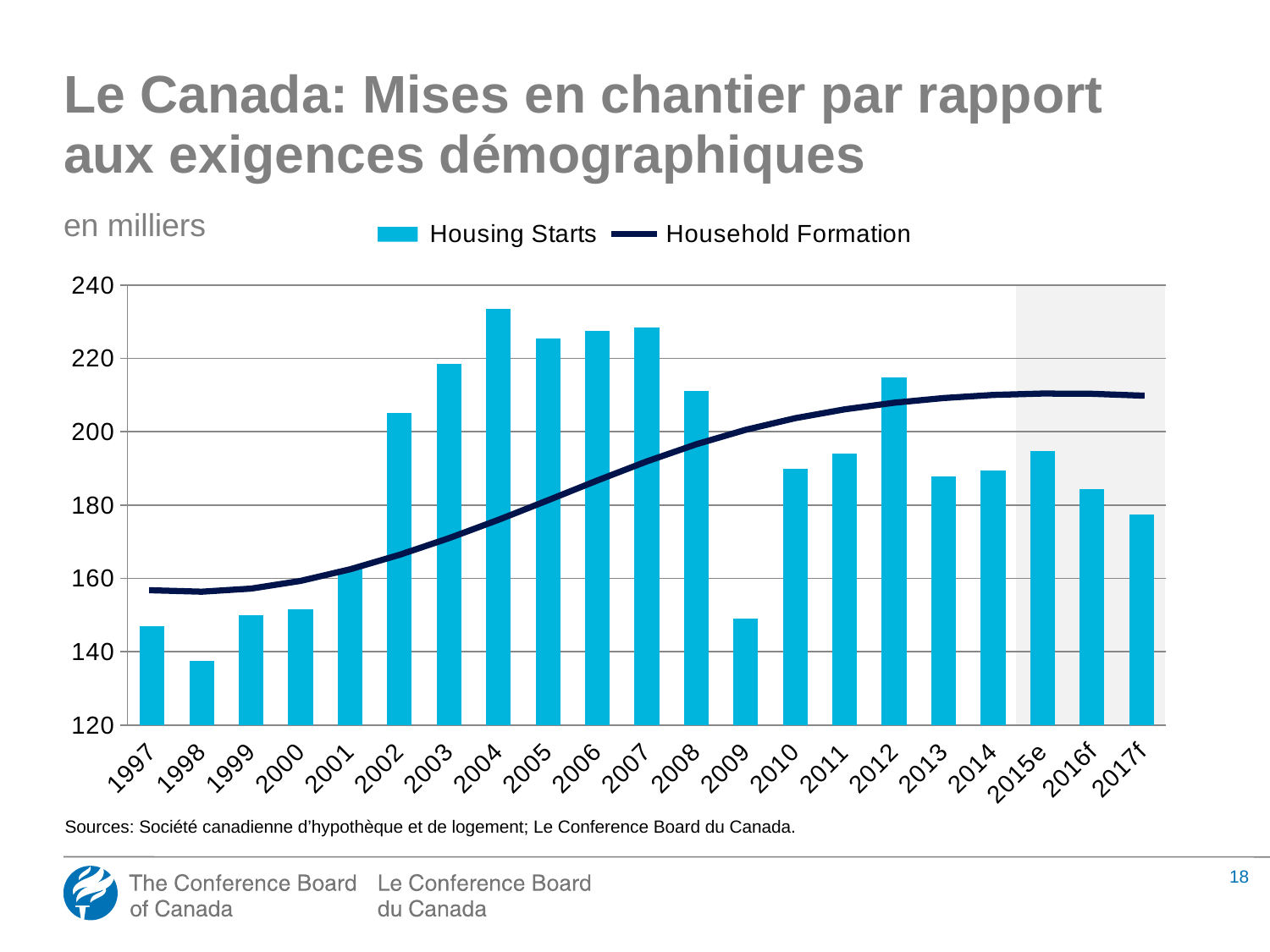
Which year has the highest Housing Starts bar? 2004 Do Housing Starts rise or fall from 1997 to 2004? rise Is the Housing Starts value for 2002 greater or less than 200? greater Is the Housing Starts value for 2017f greater or less than 180? less How many years are shown on the x axis? 21 How many series does the legend list? 2 What unit is stated above the chart? en milliers Is the Housing Starts value for 2009 greater or less than 160? less Which year has the lowest Housing Starts bar? 1998 Which year has the larger Housing Starts value, 2004 or 2008? 2004 What kind of chart is shown on the slide? A bar chart combined with a line chart